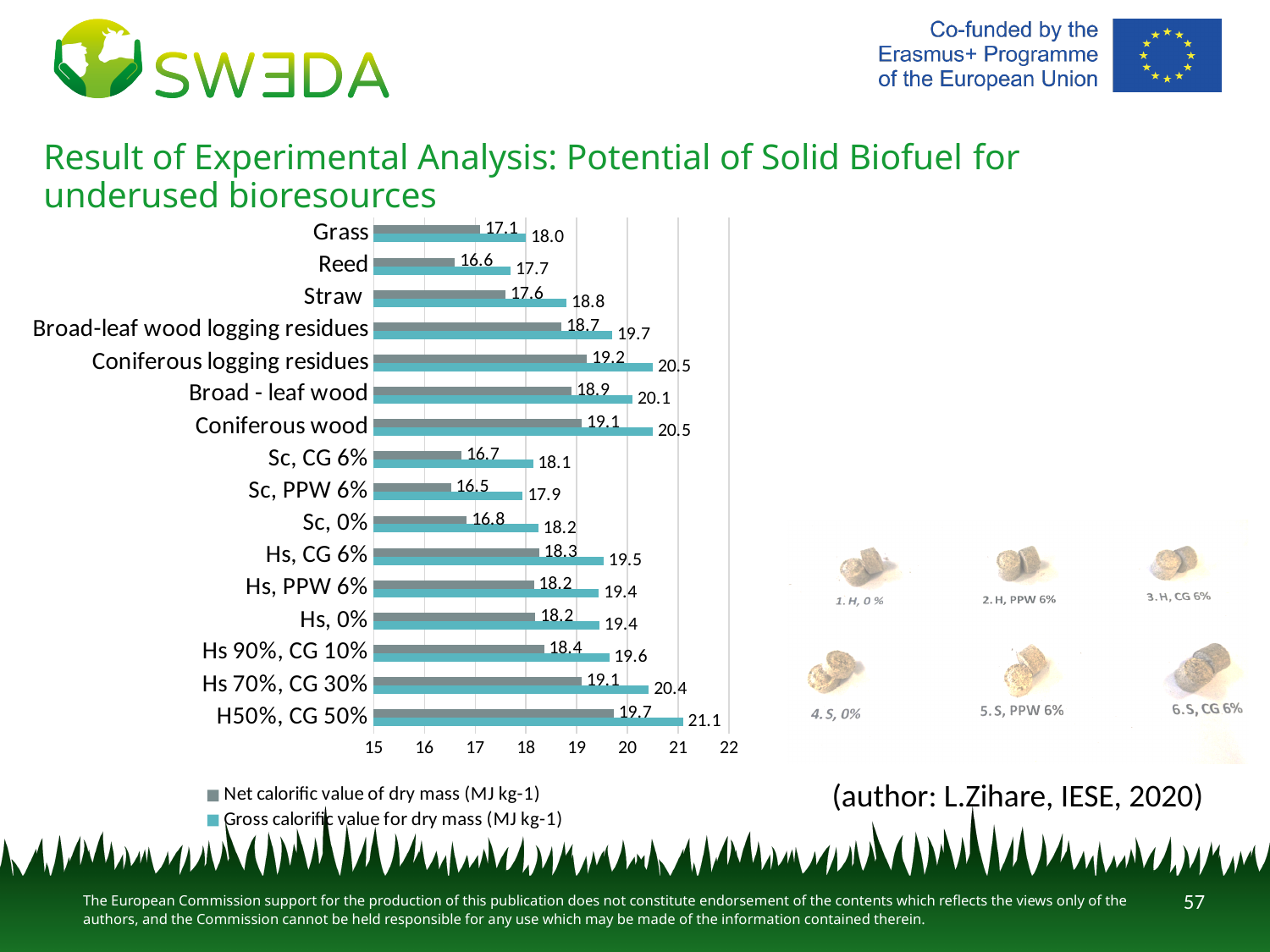
What is the difference between the gross and net calorific values for Straw? 1.2 How many series does the legend list? 2 Is the gross calorific value for H50%, CG 50% greater or less than 21? greater What is the net calorific value of dry mass for Grass? 17.1 What is the gross calorific value for dry mass for Sc, PPW 6%? 17.9 Which category has the lowest gross calorific value for dry mass? Reed Which has a higher net calorific value of dry mass, Reed or Straw? Straw What is the gross calorific value for dry mass for Coniferous logging residues? 20.5 How many categories are shown on the chart? 16 Which category has the highest gross calorific value for dry mass? H50%, CG 50% Which category has the lowest net calorific value of dry mass? Sc, PPW 6% What kind of chart is shown on the slide? Bar chart